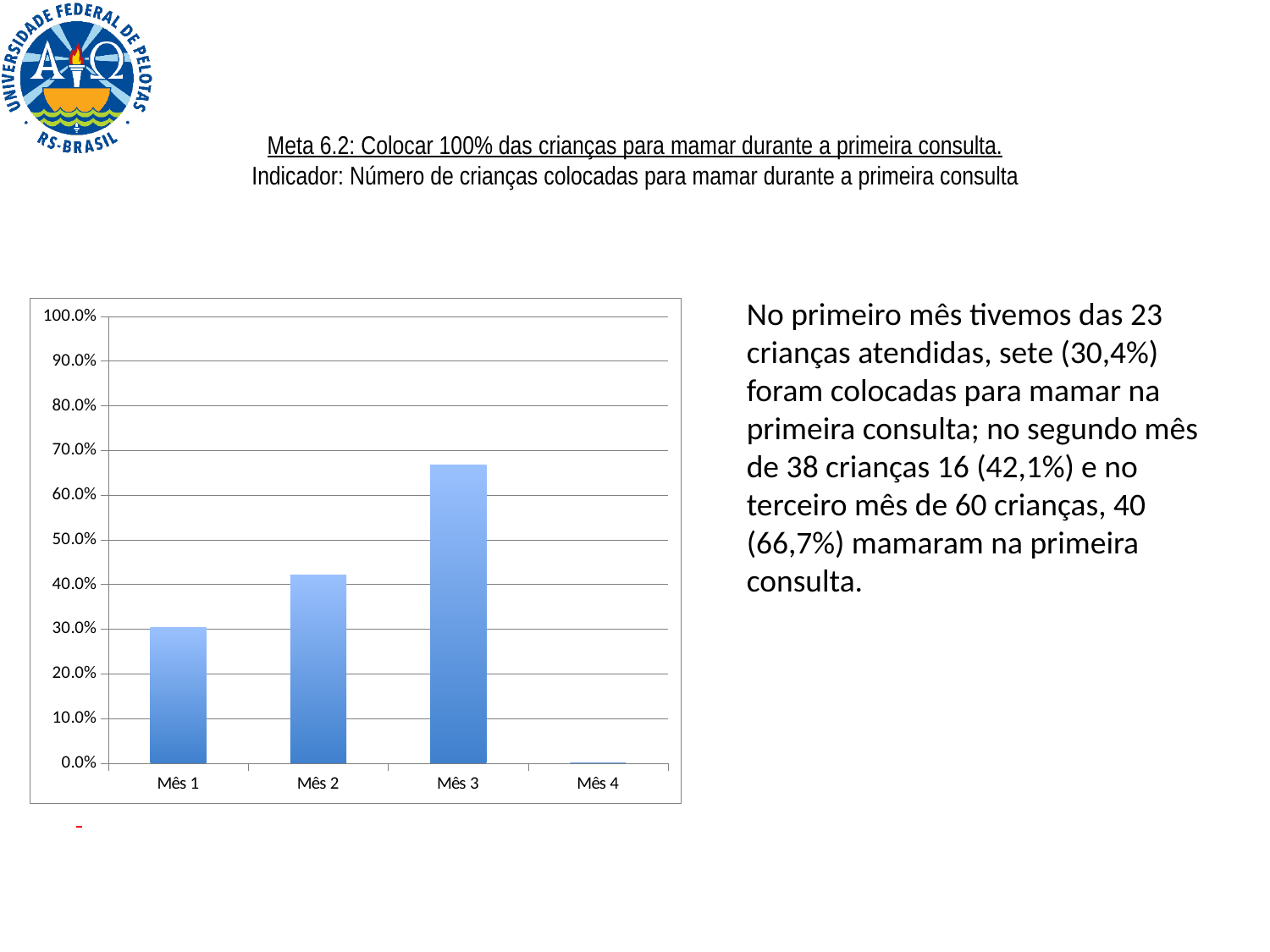
Is the value for Mês 2 greater or less than 40.0%? greater Is the value for Mês 3 greater or less than 60.0%? greater What value does the bar for Mês 4 show on the chart? 0.0% Which month has the lowest bar in the chart? Mês 4 Is the value for Mês 1 greater or less than 40.0%? less Which is larger, the value for Mês 1 or the value for Mês 2? Mês 2 What kind of chart is shown on the slide? bar chart Do the values rise or fall from Mês 1 to Mês 3? rise Which month has the highest bar in the chart? Mês 3 How many categories (months) are shown on the x axis of the chart? 4 What is the highest value shown on the chart's y axis? 100.0%